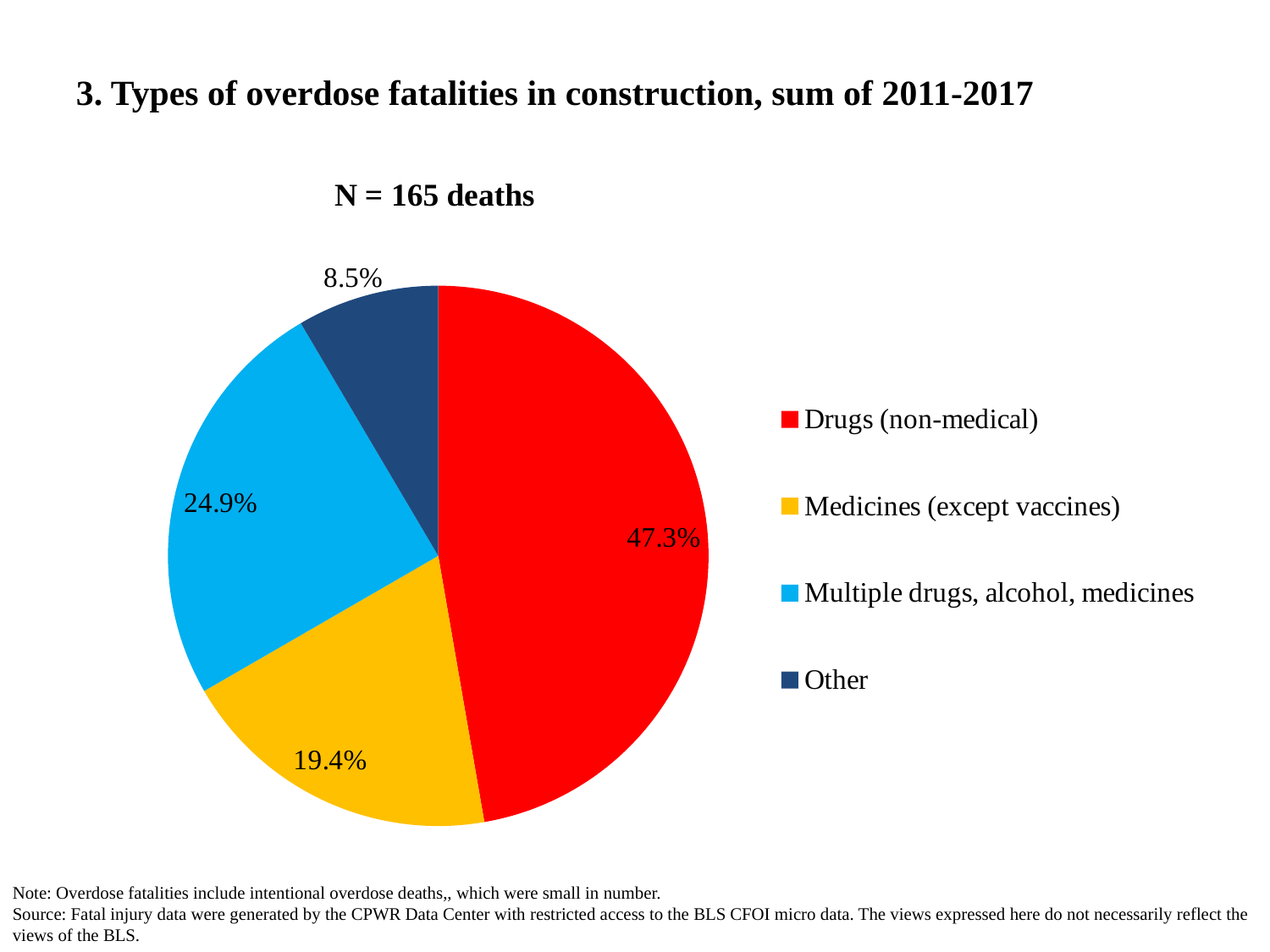
What type of chart is shown on the slide? Pie chart How many categories does the pie chart show? 4 Which category has the largest share of overdose fatalities? Drugs (non-medical) What share of overdose fatalities is attributed to Drugs (non-medical)? 47.3% What share of overdose fatalities is attributed to Multiple drugs, alcohol, medicines? 24.9% What colour represents Medicines (except vaccines) in the pie chart? Yellow Which category has the smallest share of overdose fatalities? Other What is the difference in percentage points between Drugs (non-medical) and Multiple drugs, alcohol, medicines? 22.4 How many deaths does the chart say the data is based on (N)? 165 deaths What share of overdose fatalities is attributed to Medicines (except vaccines)? 19.4% What share of overdose fatalities is attributed to Other? 8.5% Which is larger: the share for Medicines (except vaccines) or the share for Multiple drugs, alcohol, medicines? Multiple drugs, alcohol, medicines